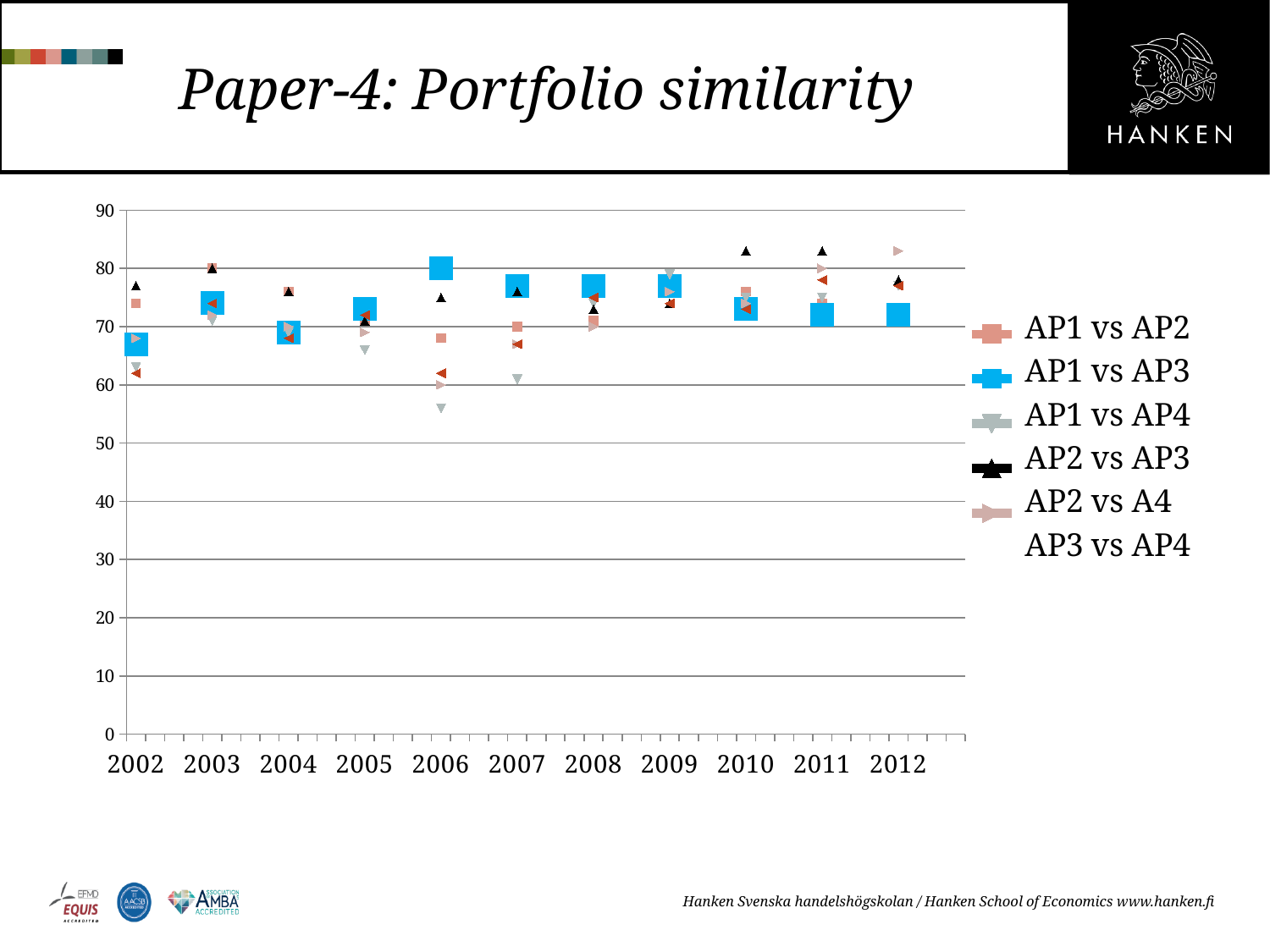
Is the value for AP1 vs AP3 in 2002 greater or less than 70? less Is the value for AP2 vs AP3 in 2010 greater or less than 80? greater Is the value for AP1 vs AP3 in 2012 greater or less than 70? greater In which year is the AP1 vs AP4 value lowest? 2006 How many series does the chart legend list? 6 Which colour is used for the AP1 vs AP3 series in the chart? blue How many years are shown on the x axis of the chart? 11 In which year is the AP1 vs AP3 value highest? 2006 What is the title of the slide containing the chart? Paper-4: Portfolio similarity What kind of chart is shown on the slide? scatter chart